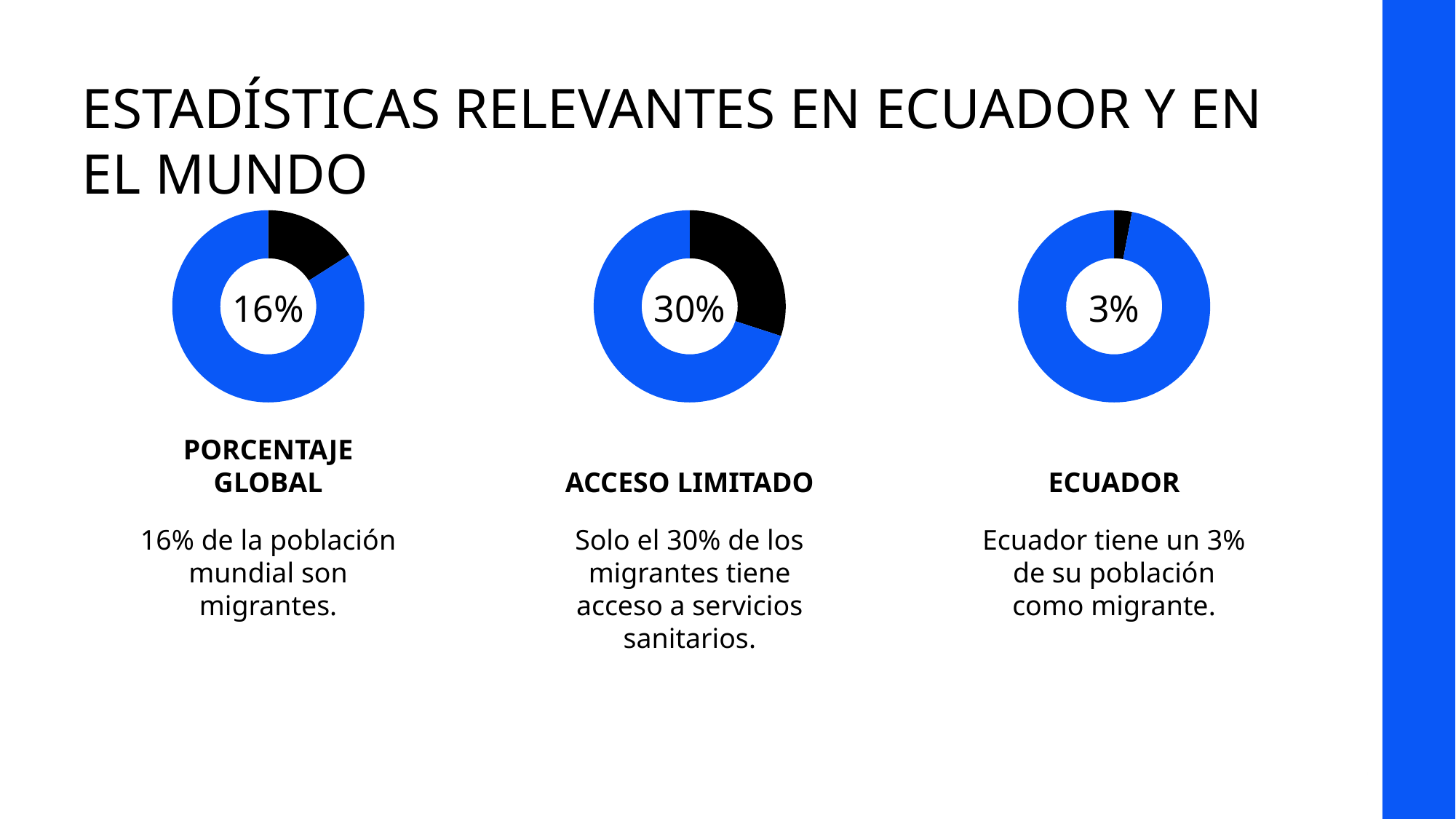
What colour is the slice that represents the highlighted percentage in each donut chart? Black What value is shown in the centre of the PORCENTAJE GLOBAL donut chart? 16% Which of the three donut charts shows the highest percentage? ACCESO LIMITADO What kind of chart is used for the three statistics on the slide? Donut (pie) chart In the PORCENTAJE GLOBAL donut chart, what share of the ring does the black slice represent? 16% What is the difference between the ACCESO LIMITADO percentage and the ECUADOR percentage? 27% What value is shown in the centre of the ECUADOR donut chart? 3% Which of the three donut charts shows the lowest percentage? ECUADOR How many donut charts are on the slide? 3 What is the difference between the ACCESO LIMITADO percentage and the PORCENTAJE GLOBAL percentage? 14% Which is larger, the percentage in the PORCENTAJE GLOBAL chart or the percentage in the ECUADOR chart? PORCENTAJE GLOBAL What value is shown in the centre of the ACCESO LIMITADO donut chart? 30%